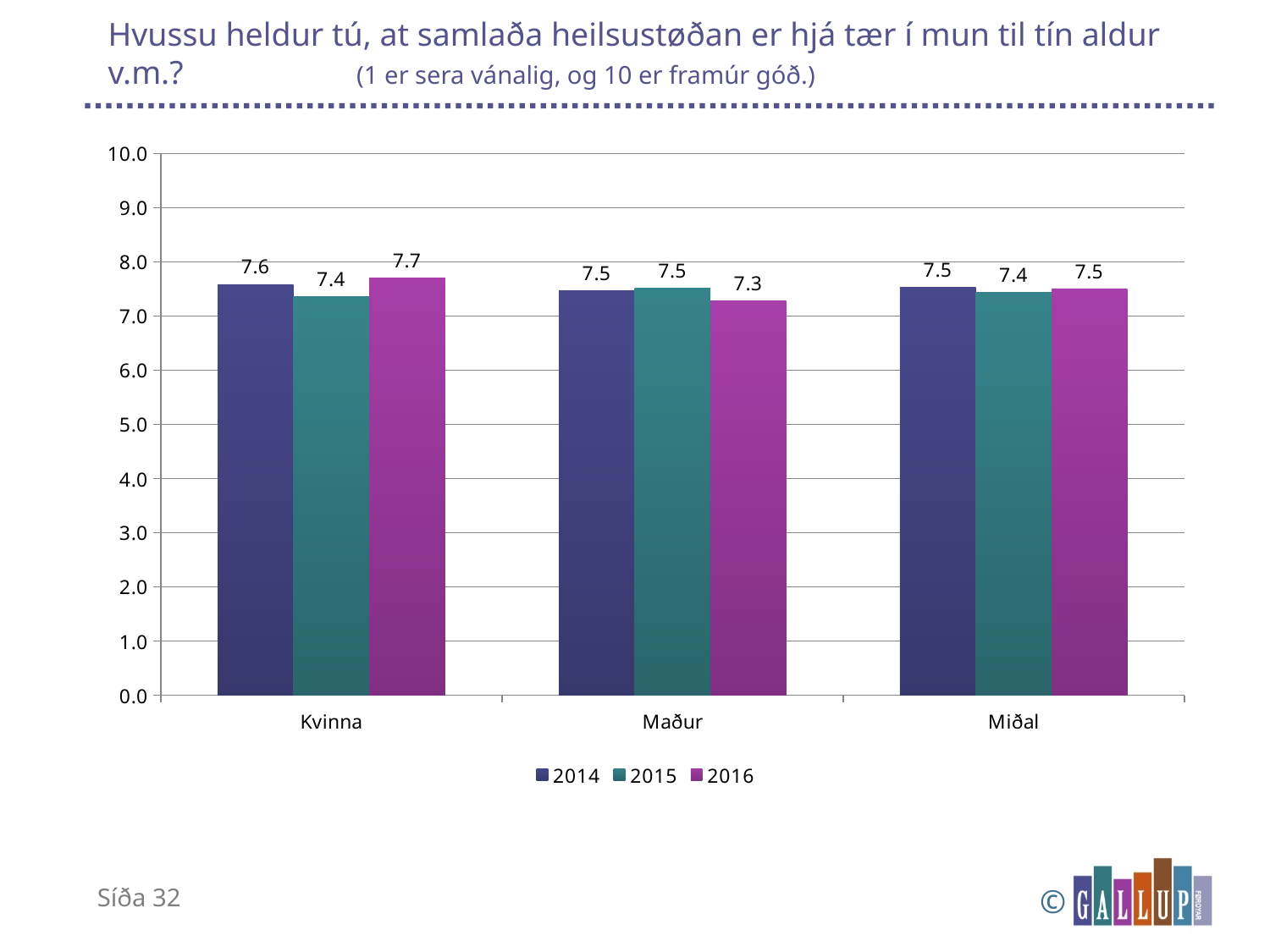
How many series does the legend list? 3 Which category has the highest value in 2016? Kvinna What is the difference between the 2016 values for Kvinna and Maður? 0.4 What is the value for Maður in 2015? 7.5 What kind of chart is shown on the slide? bar chart How many categories are shown on the x axis? 3 What is the value for Kvinna in 2016? 7.7 Which category has the lowest value in 2016? Maður What is the value for Maður in 2016? 7.3 Is the value for Kvinna in 2016 greater or less than 7.0? greater Which is larger for Kvinna: the 2014 value or the 2015 value? 2014 What is the value for Miðal in 2014? 7.5